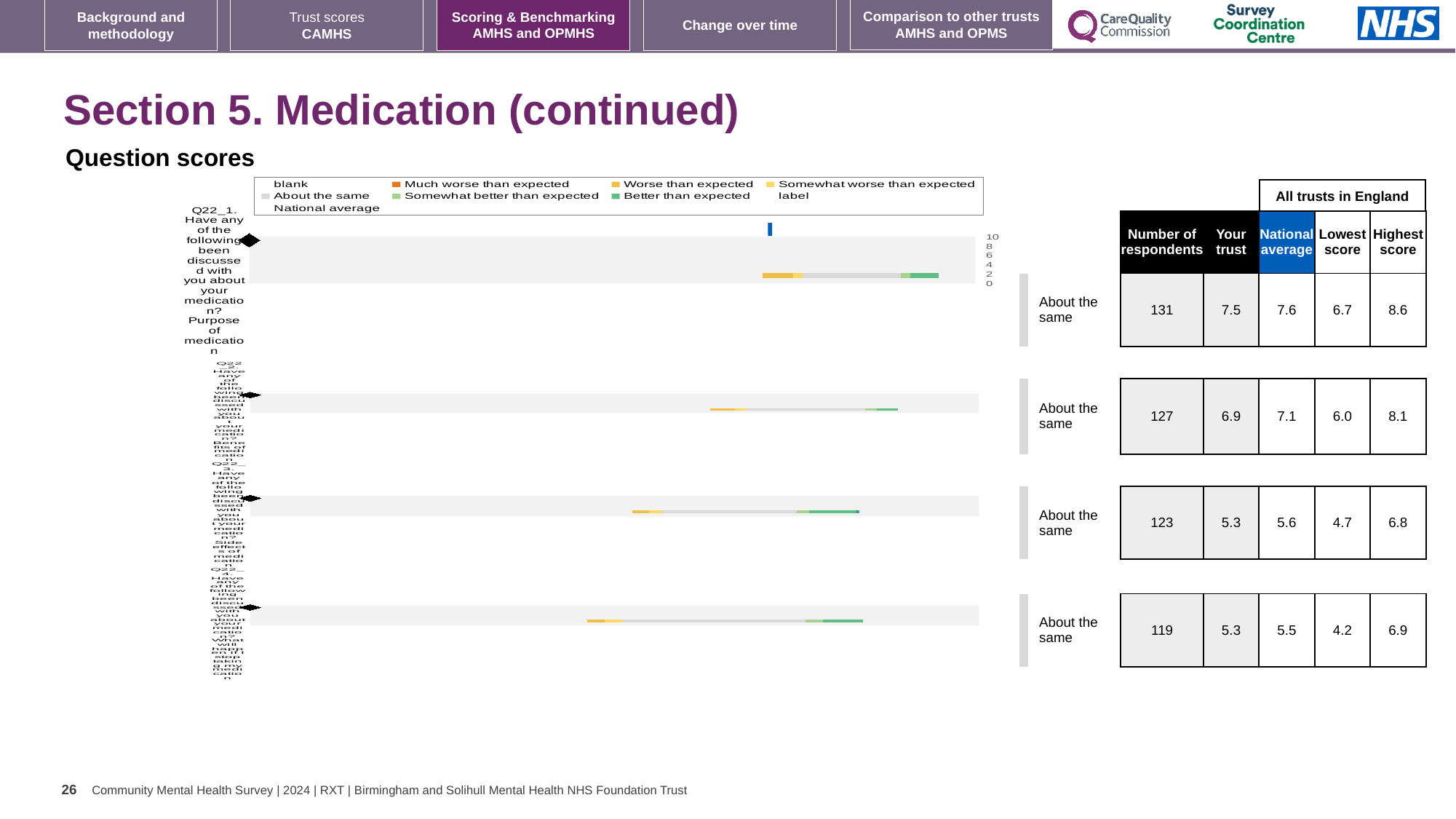
What is the highest tick value shown on the chart's axis? 10 Which legend entry is shown in dark orange in the chart? Much worse than expected What kind of chart is shown under the 'Question scores' heading? bar chart How many question bars are plotted in the chart? 4 What is the label of the first (top) bar in the chart? Q22_1. Have any of the following been discussed with you about your medication? Purpose of medication How many entries does the chart's legend list? 9